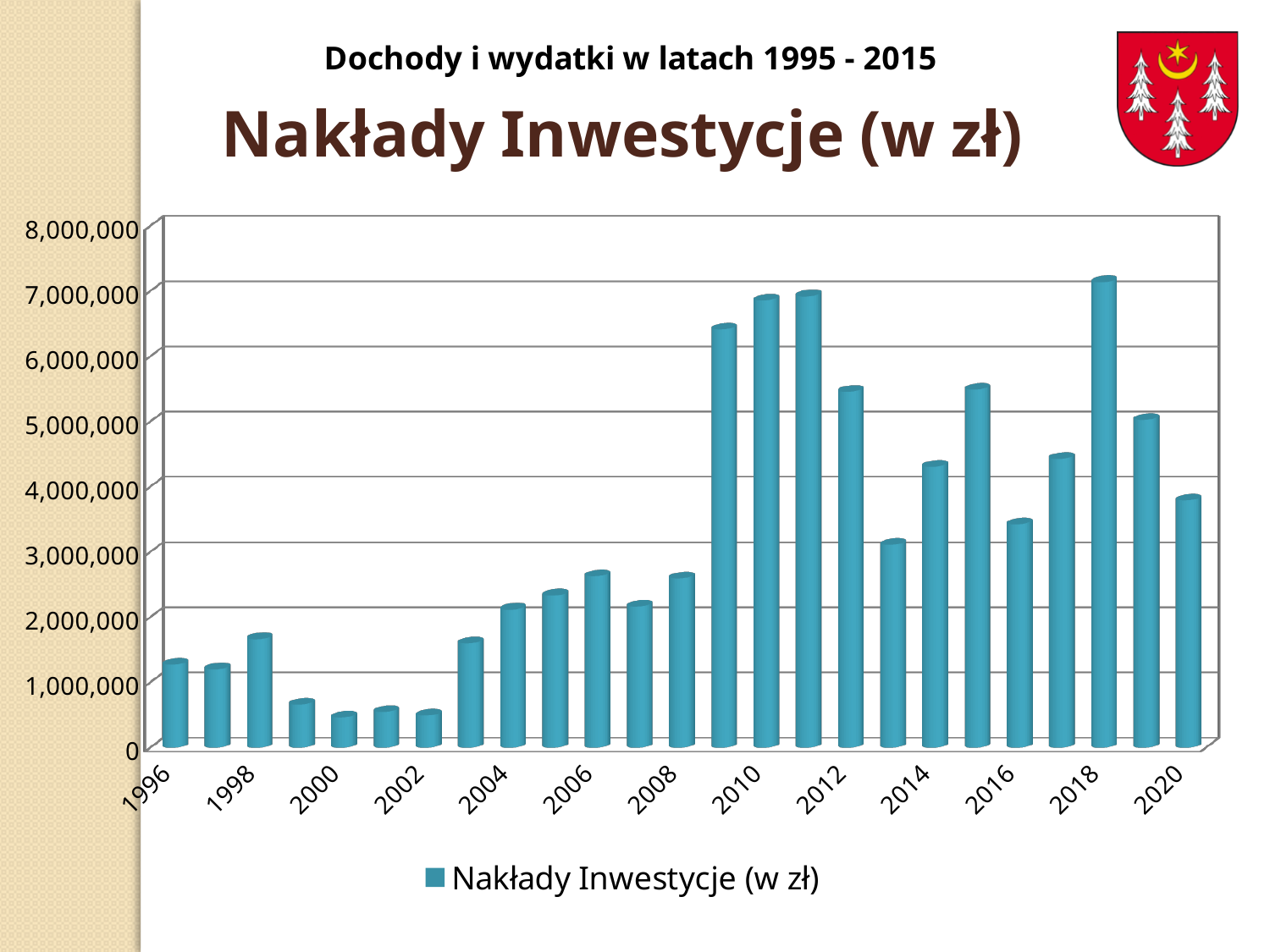
Which year has the highest value in the chart? 2018 Which is larger, the value for 2010 or the value for 2012? 2010 Is the value for 2012 greater or less than 5,000,000? greater Is the value for 2018 greater or less than 7,000,000? greater Is the value for 2000 greater or less than 1,000,000? less Which is larger, the value for 2014 or the value for 2016? 2014 How many series does the legend list? 1 What kind of chart is shown on the slide? bar chart What is the legend entry for the series in the chart? Nakłady Inwestycje (w zł) How many bars (years) are plotted in the chart? 25 Do the values rise or fall from 2018 to 2020? fall